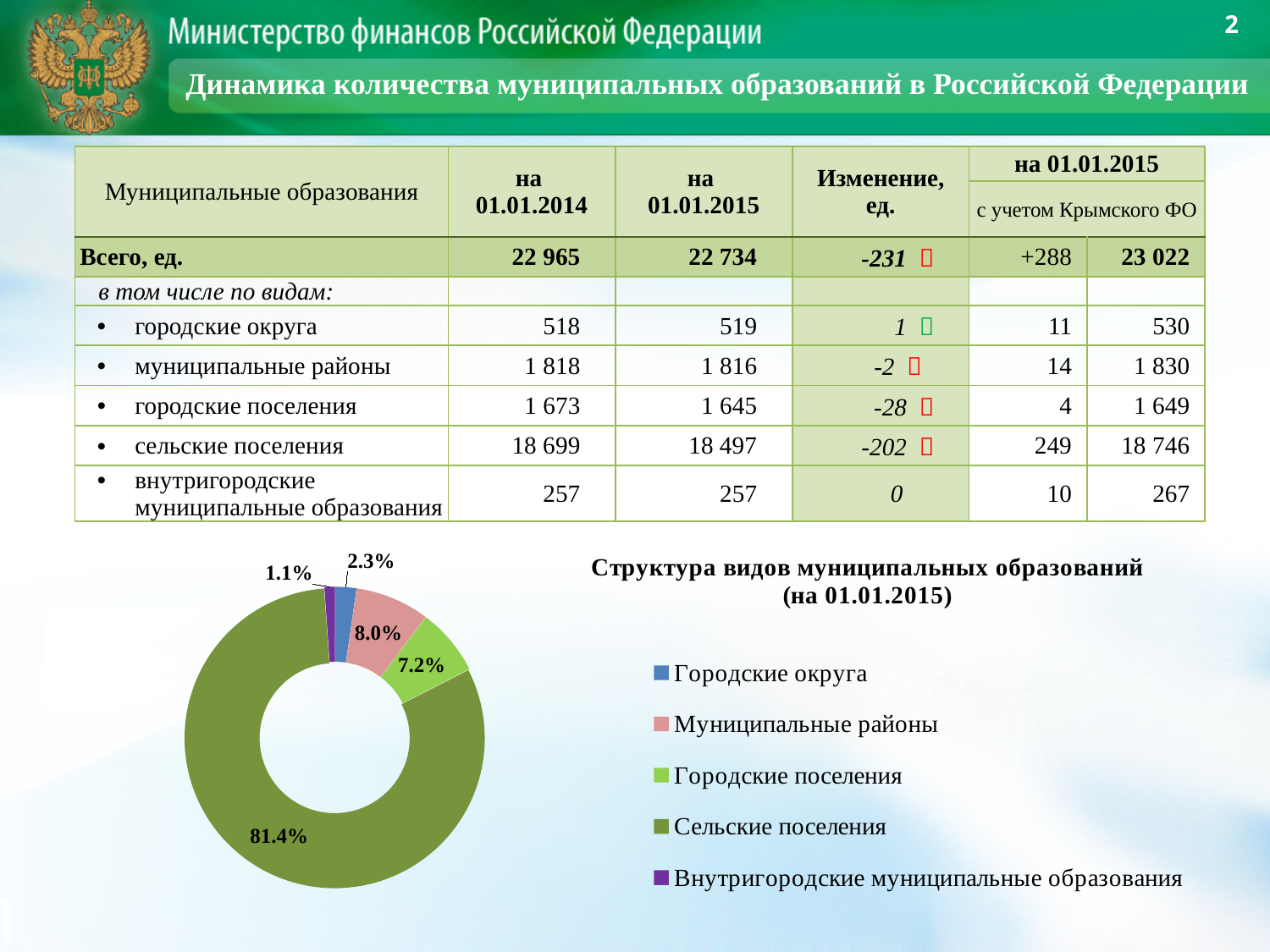
What is the title of the chart on the slide? Структура видов муниципальных образований (на 01.01.2015) What share of the chart is Внутригородские муниципальные образования? 1.1% What share of the chart is Городские округа? 2.3% Which has a larger share in the chart, Муниципальные районы or Городские поселения? Муниципальные районы How many categories does the chart's legend list? 5 What type of chart is shown on the slide? Doughnut (pie) chart What share of the chart is Муниципальные районы? 8.0% What is the difference in percentage points between the shares of Муниципальные районы and Городские округа? 5.7 percentage points Which category has the largest share in the chart? Сельские поселения Which category has the smallest share in the chart? Внутригородские муниципальные образования